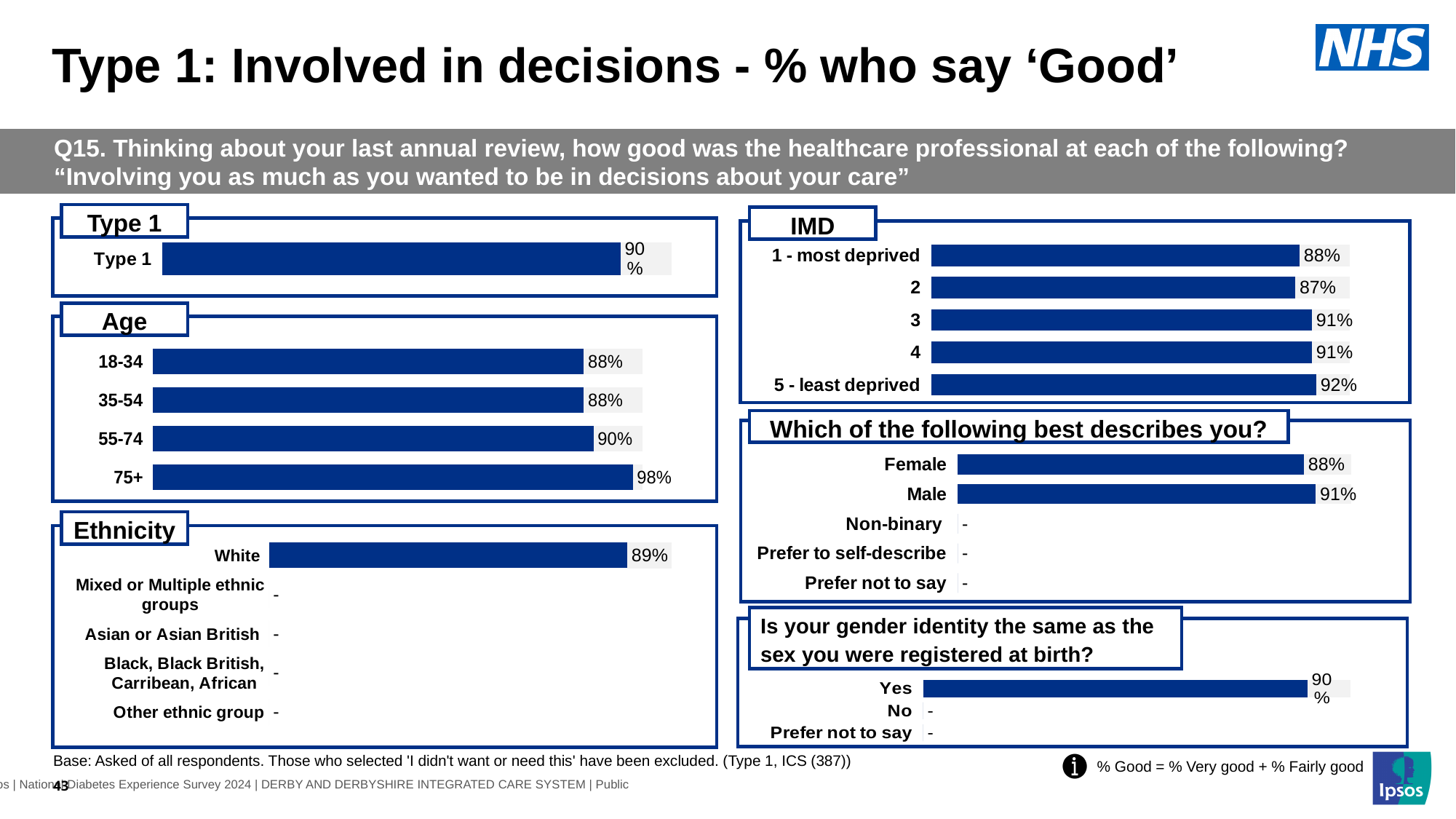
In the 'Which of the following best describes you?' chart, what is the difference between Male and Female? 3 percentage points In the IMD chart, which category has the lowest value? 2 In the Age chart, what is the difference between the values for 75+ and 55-74? 8 percentage points In the Age chart, which age group has the highest value? 75+ In the IMD chart, what is the value for 1 - most deprived? 88% In the Type 1 chart, what is the value for Type 1? 90% In the Ethnicity chart, what is the value for White? 89% In the 'Which of the following best describes you?' chart, which is larger, Female or Male? Male In the 'Is your gender identity the same as the sex you were registered at birth?' chart, what is the value for Yes? 90% In the IMD chart, which category has the highest value? 5 - least deprived In the Age chart, what is the value for 75+? 98% In the Age chart, how many age categories are shown? 4